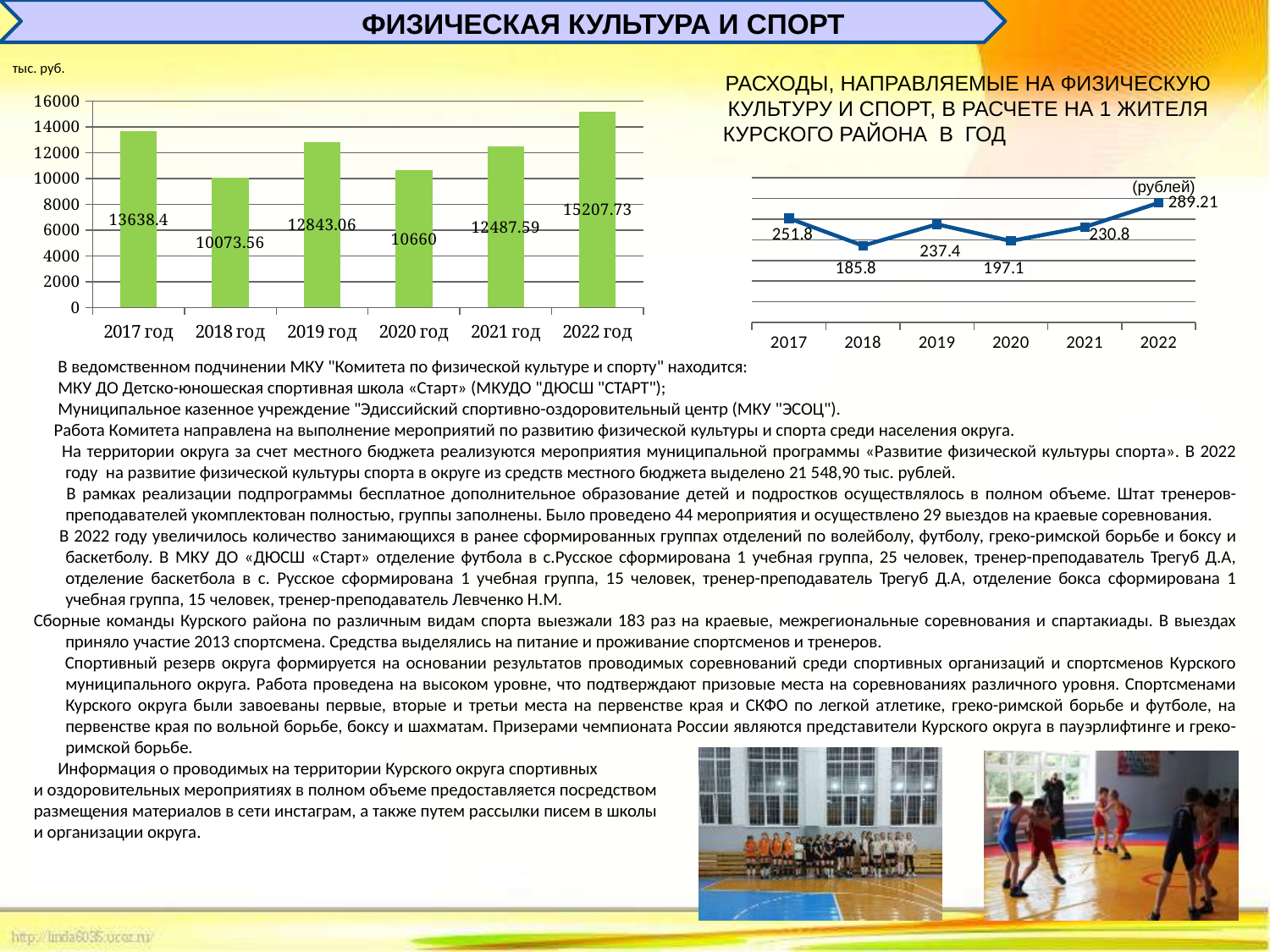
In the line chart on the right, what is the difference between the values for 2017 and 2020? 54.7 In the bar chart on the left, which is larger: the value for 2017 год or the value for 2019 год? 2017 год In the bar chart on the left, which year has the lowest value? 2018 год How many bars are in the bar chart on the left? 6 What type of chart is shown on the left side of the slide? bar chart In the bar chart on the left, what is the difference between the values for 2022 год and 2021 год? 2720.14 In the bar chart on the left, what is the value for 2022 год? 15207.73 In the bar chart on the left, which year has the highest value? 2022 год In the line chart on the right, which year has the lowest value? 2018 In the line chart on the right, what is the value for 2022? 289.21 In the bar chart on the left, what is the value for 2018 год? 10073.56 In the line chart on the right, what is the value for 2018? 185.8